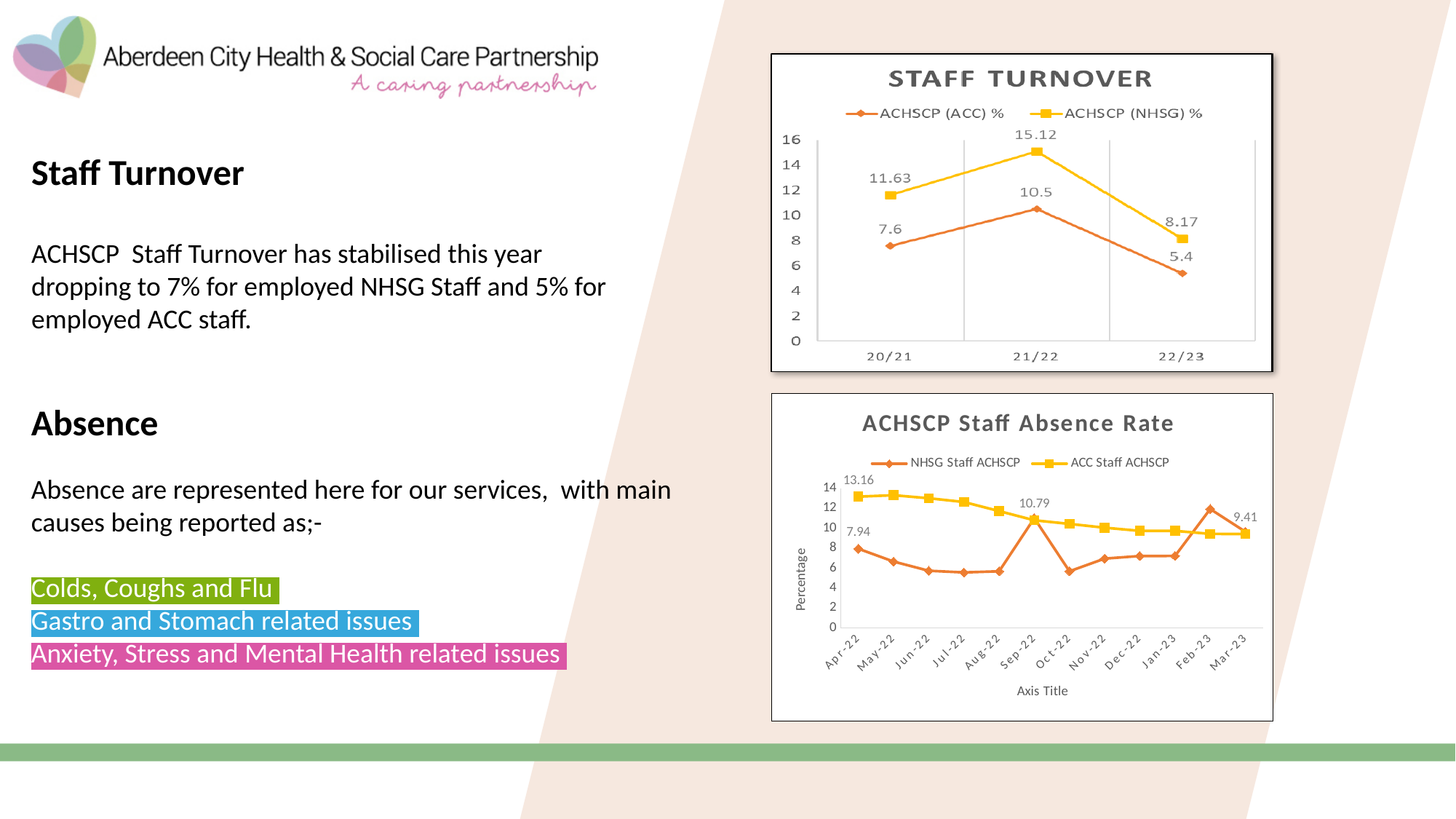
What kind of chart is the ACHSCP Staff Absence Rate chart? Line chart In the STAFF TURNOVER chart, how many series does the legend list? 2 In the STAFF TURNOVER chart, how many years are shown on the x axis? 3 In the STAFF TURNOVER chart, what is the difference between the ACHSCP (NHSG) % and ACHSCP (ACC) % values for 20/21? 4.03 In the ACHSCP Staff Absence Rate chart, what is the ACC Staff ACHSCP value for Apr-22? 13.16 In the ACHSCP Staff Absence Rate chart, what is the NHSG Staff ACHSCP value for Apr-22? 7.94 In the STAFF TURNOVER chart, which year has the highest ACHSCP (NHSG) % value? 21/22 In the STAFF TURNOVER chart, what is the ACHSCP (NHSG) % value for 21/22? 15.12 In the STAFF TURNOVER chart, what is the ACHSCP (ACC) % value for 22/23? 5.4 In the ACHSCP Staff Absence Rate chart, how many months are shown on the x axis? 12 In the STAFF TURNOVER chart, what is the ACHSCP (ACC) % value for 20/21? 7.6 In the STAFF TURNOVER chart, which year has the lowest ACHSCP (ACC) % value? 22/23